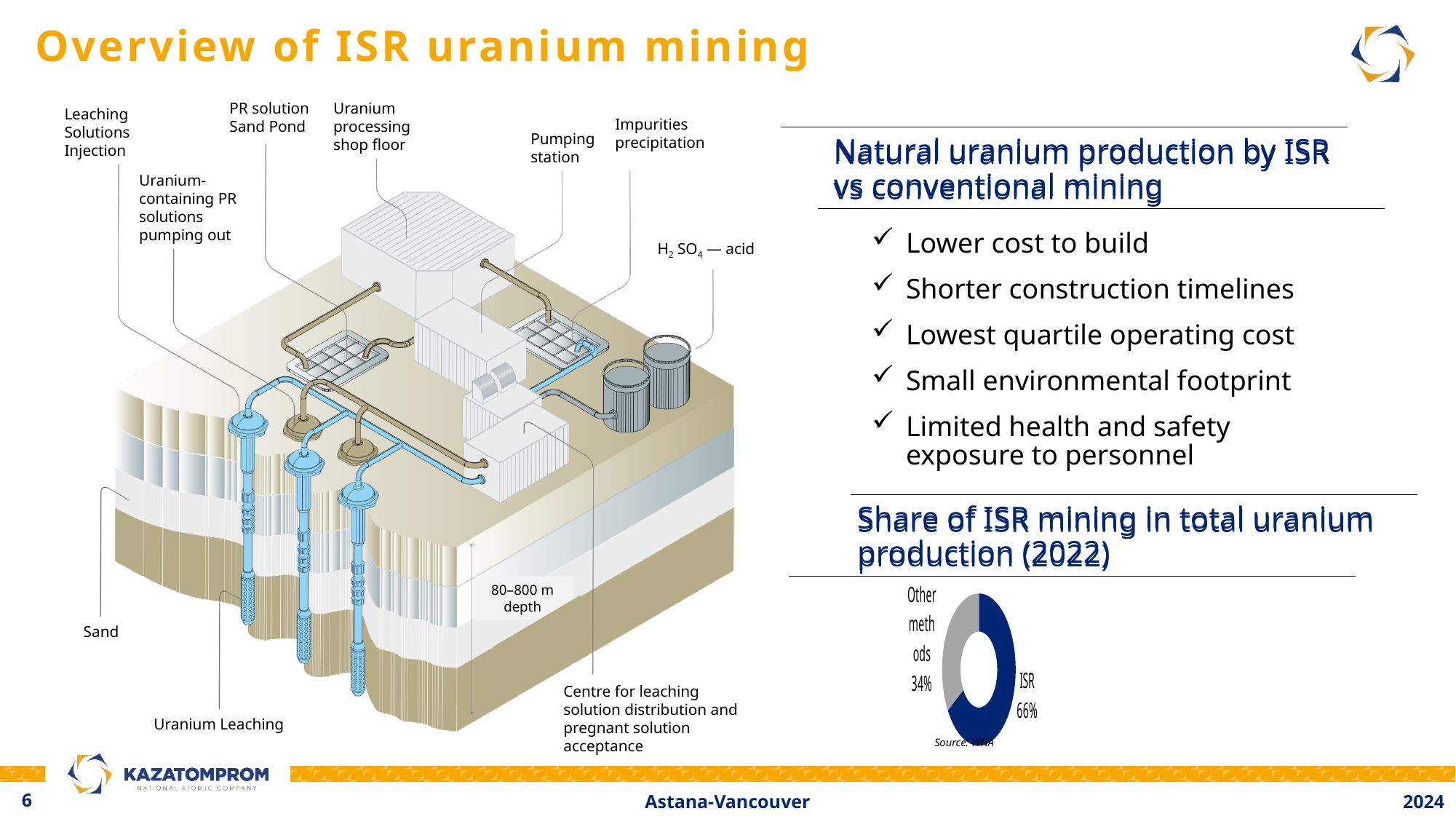
Which slice of the pie chart is larger, ISR or other methods? ISR What is the difference in percentage points between the ISR share and the other methods share in the pie chart? 32 Is the ISR share in the pie chart greater or less than 50%? greater Which category has the largest share in the pie chart? ISR What kind of chart shows the share of ISR mining in total uranium production? Doughnut chart What share of total uranium production in 2022 do other methods account for in the pie chart? 34% What is the title of the pie chart on the slide? Share of ISR mining in total uranium production (2022) What share of total uranium production in 2022 does ISR account for in the pie chart? 66% Which category has the smallest share in the pie chart? Other methods What source is cited below the pie chart? WNA How many slices does the pie chart have? 2